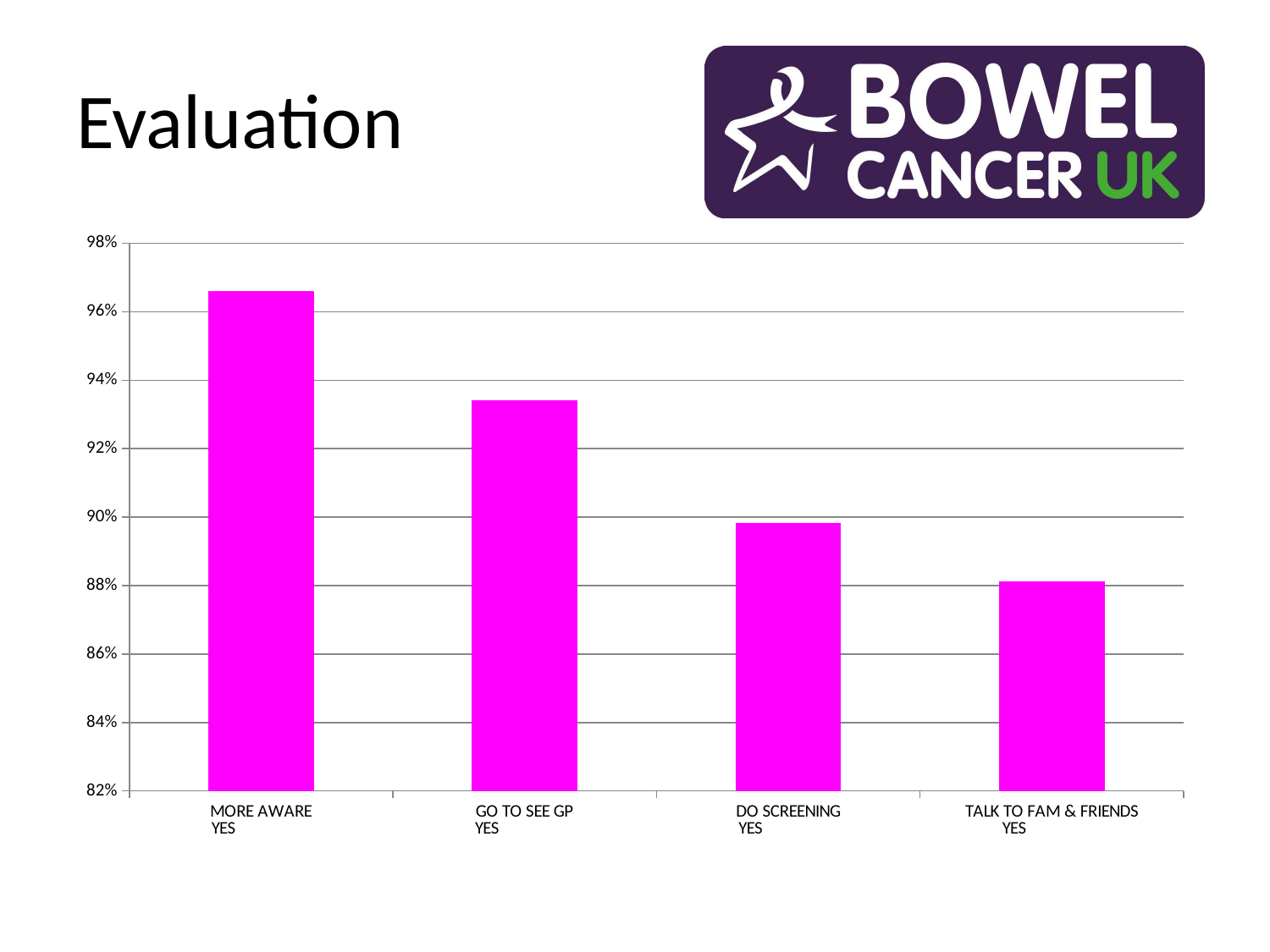
Is the value for GO TO SEE GP YES greater or less than 92%? greater Which category has the lowest value? TALK TO FAM & FRIENDS YES Is the value for DO SCREENING YES greater or less than 88%? greater Is the value for MORE AWARE YES greater or less than 96%? greater Which category has the highest value? MORE AWARE YES How many categories are shown on the chart? 4 What kind of chart is shown on the slide? bar chart Which is larger, the value for GO TO SEE GP YES or the value for DO SCREENING YES? GO TO SEE GP YES Do the values rise or fall from left to right across the categories? fall What colour are the bars in the chart? magenta